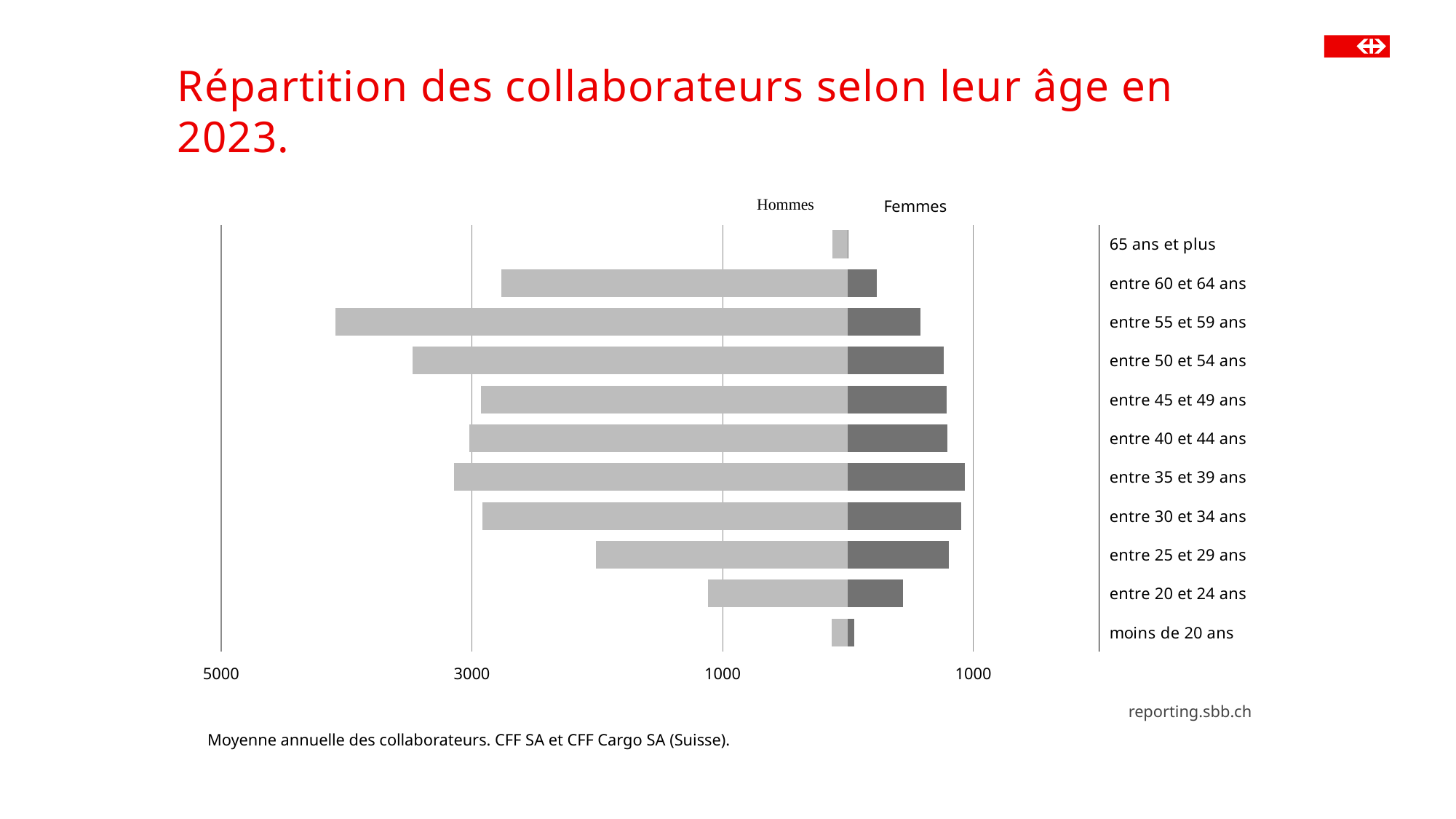
Which is larger for Hommes: 'entre 55 et 59 ans' or 'entre 50 et 54 ans'? entre 55 et 59 ans Which series is shown in the darker grey bars? Femmes Is the Hommes value for 'entre 60 et 64 ans' greater or less than 3000? less Is the Hommes value for 'entre 25 et 29 ans' greater or less than 1000? greater What is the title of the chart on the slide? Répartition des collaborateurs selon leur âge en 2023. Is the Hommes value for 'entre 55 et 59 ans' greater or less than 3000? greater What kind of chart is shown on the slide? bar chart How many series does the chart show? 2 Which age category has the highest value for Hommes? entre 55 et 59 ans For 'entre 35 et 39 ans', which series has the larger value, Hommes or Femmes? Hommes How many age categories are shown in the chart? 11